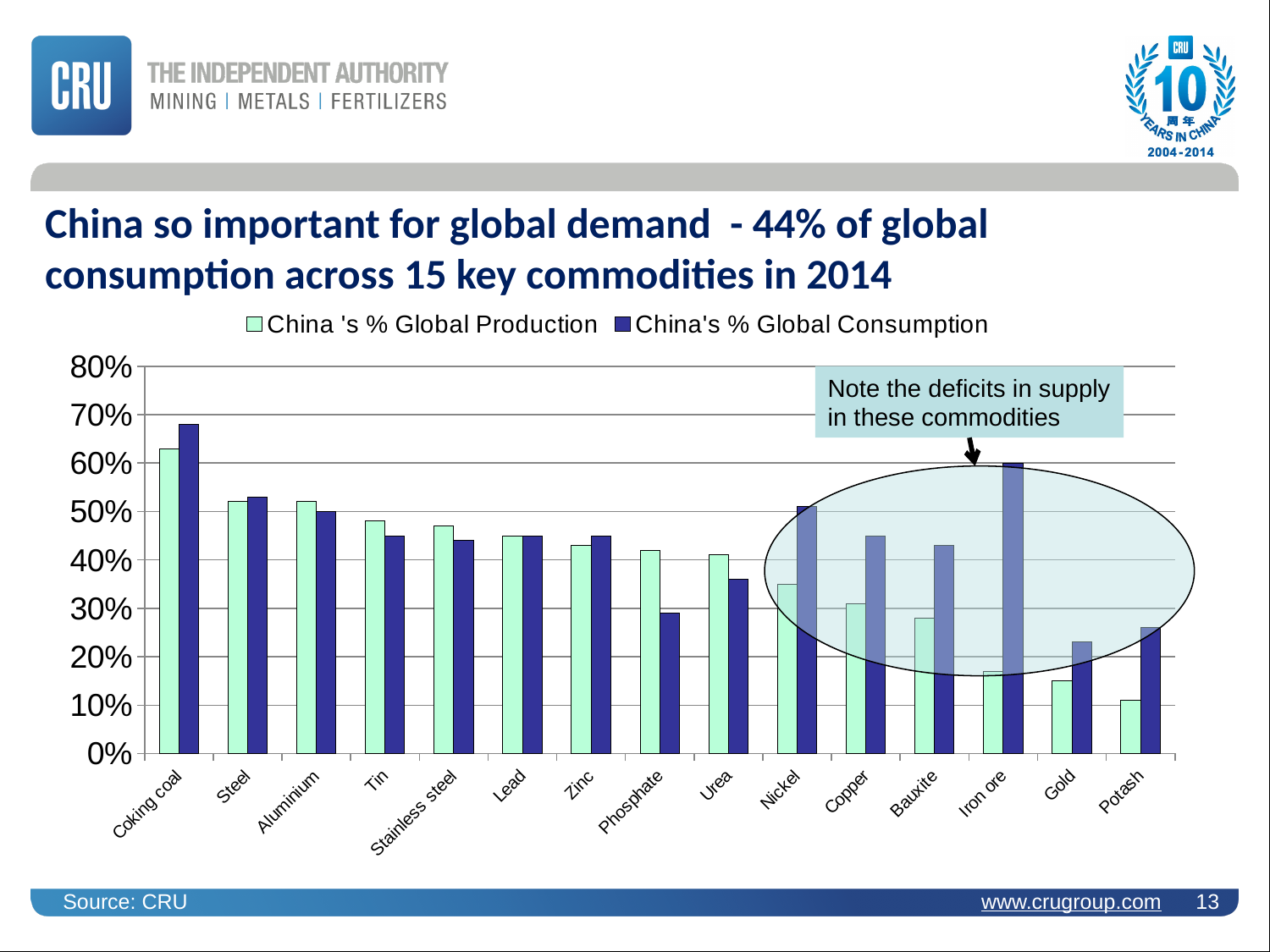
Is the value for China's % Global Production for Potash greater or less than 20%? less How many commodities are shown on the x axis of the chart? 15 For Phosphate, which is larger: China's % Global Production or China's % Global Consumption? China's % Global Production Which commodity has the highest value for China's % Global Consumption? Coking coal How many series does the chart legend list? 2 What does the text box annotation on the chart say? Note the deficits in supply in these commodities Which commodity has the lowest value for China's % Global Production? Potash Is the value for China's % Global Consumption for Iron ore greater or less than 50%? greater Is the value for China's % Global Production for Coking coal greater or less than 60%? greater For Iron ore, which is larger: China's % Global Production or China's % Global Consumption? China's % Global Consumption Which commodity has the highest value for China's % Global Production? Coking coal What kind of chart is shown on the slide? Bar chart